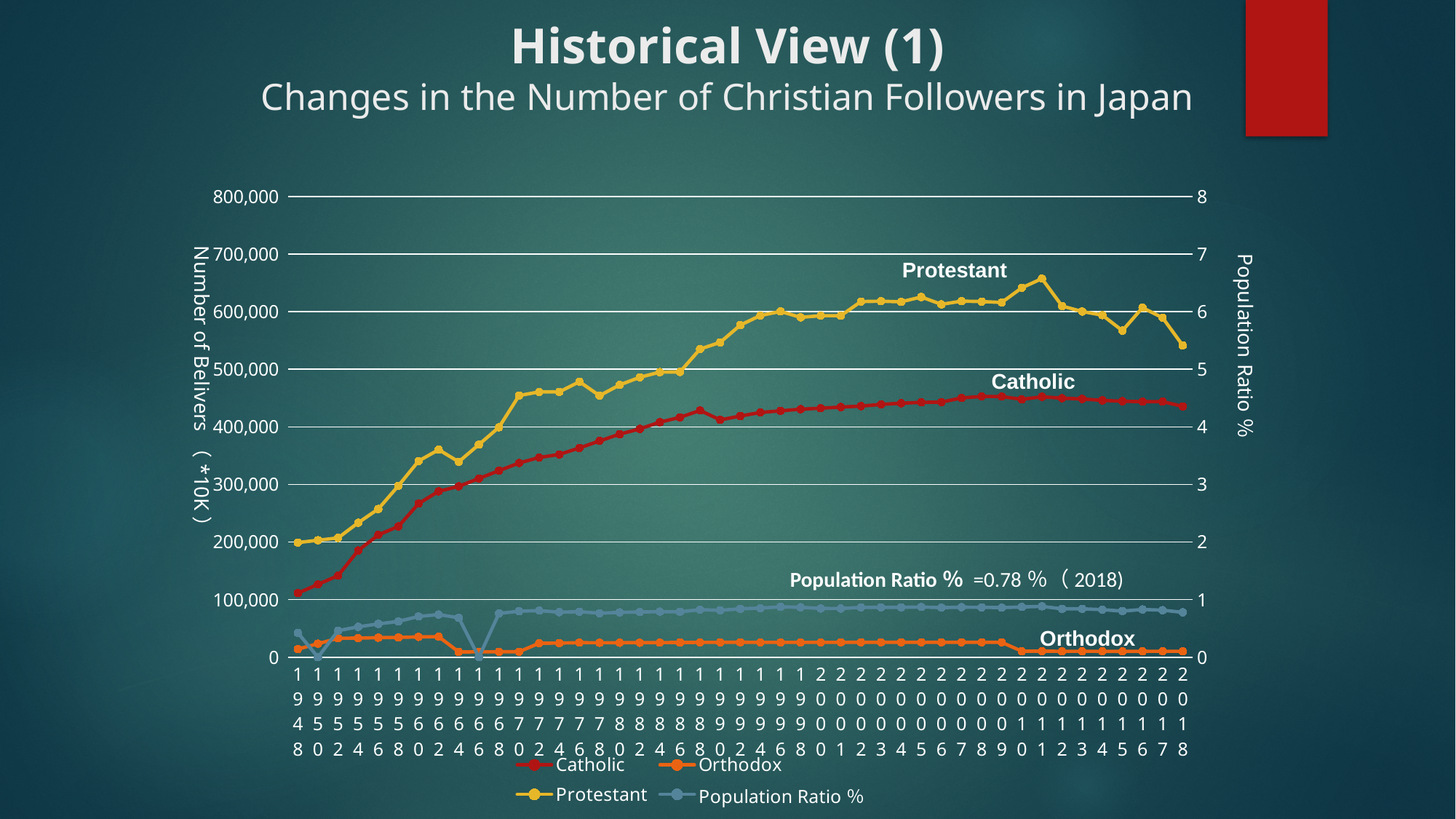
Which is larger in 2000, the Catholic value or the Orthodox value? Catholic In which year does the Protestant series reach its highest point? 2011 Is the Catholic value for 2018 greater or less than 400,000? greater What is the title of the right-hand vertical axis? Population Ratio % Which series has the highest number of believers in 2018? Protestant How many series does the legend list? 4 Which series has the lowest number of believers in 2018? Orthodox Does the Catholic series rise or fall from 1948 to 2010? rise What type of chart is shown on the slide? line chart What is the Population Ratio % value given for 2018? 0.78% Is the Catholic value for 1948 greater or less than 200,000? less Is the Protestant value for 2018 greater or less than 500,000? greater